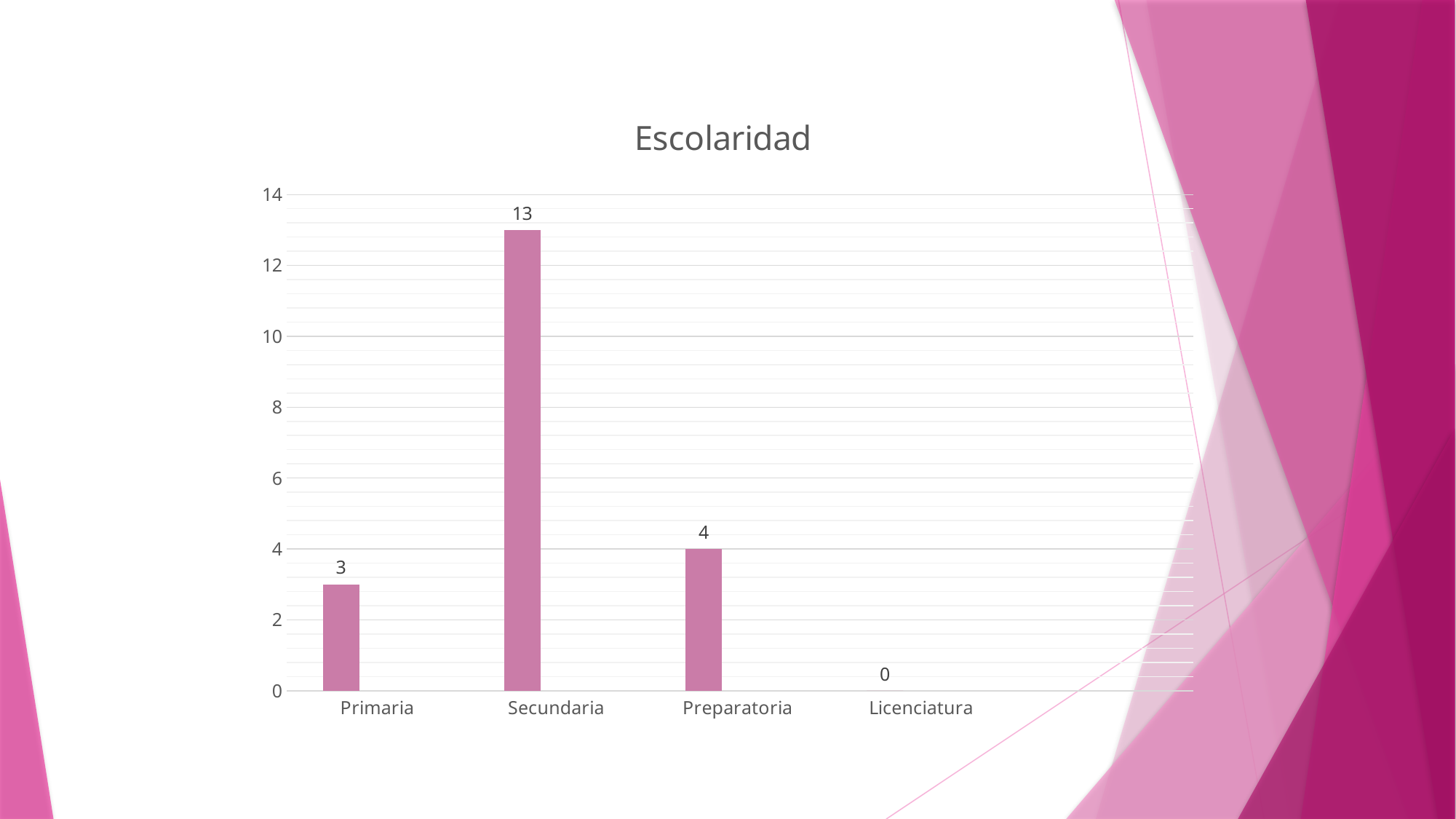
Which category has the highest value? Secundaria Which category has the lowest value? Licenciatura What is the difference between the values for Secundaria and Preparatoria? 9 Is the value for Secundaria greater or less than 10? greater What is the title of the chart? Escolaridad What is the value for Primaria? 3 What kind of chart is shown on the slide? bar chart What is the value for Licenciatura? 0 What is the value for Preparatoria? 4 How many categories are shown on the x axis? 4 Which is larger, the value for Primaria or the value for Preparatoria? Preparatoria What is the value for Secundaria? 13